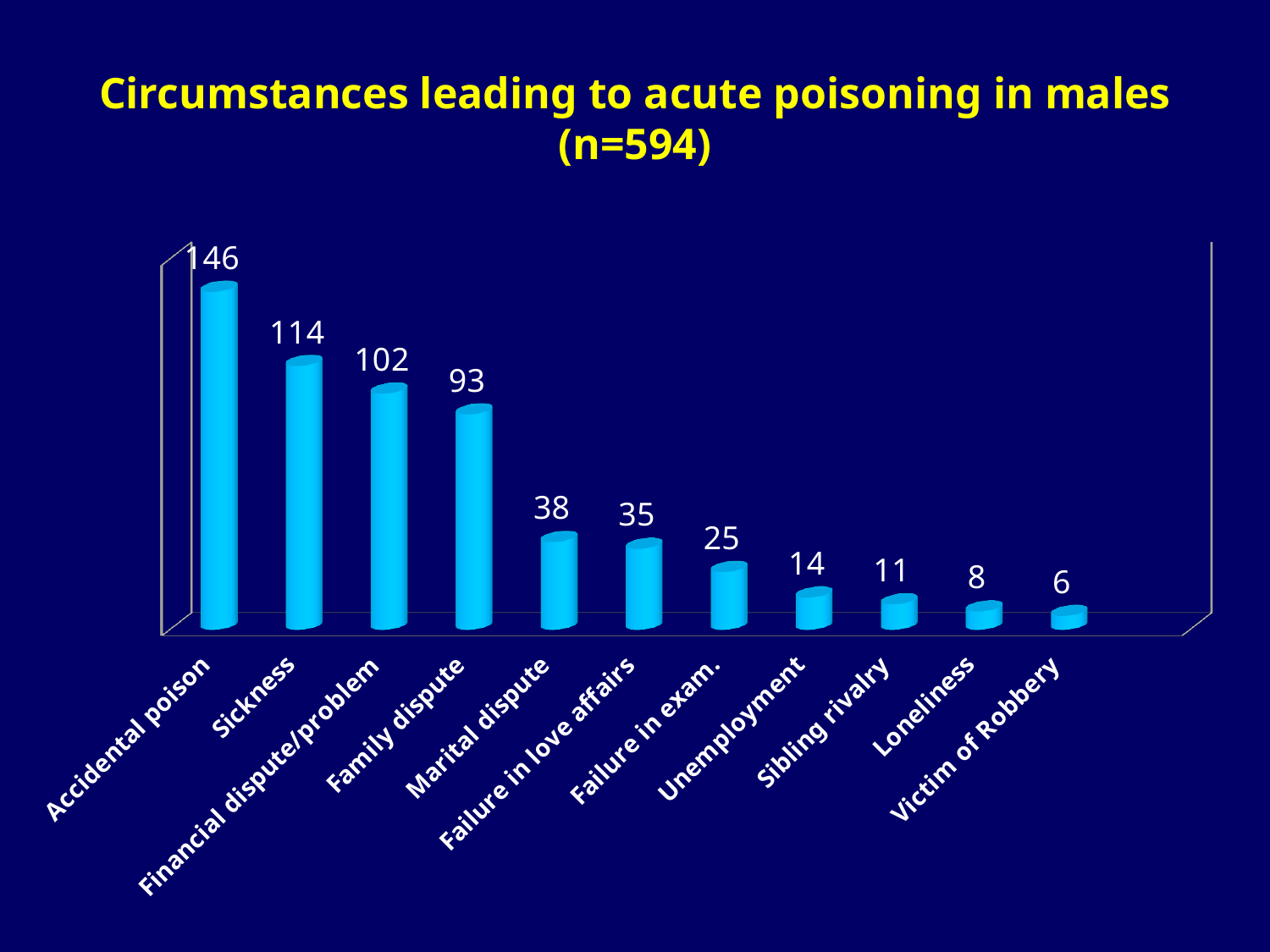
What is the value for Accidental poison? 146 Which circumstance has the lowest value? Victim of Robbery What is the value for Failure in love affairs? 35 What is the value for Loneliness? 8 Which is larger, the value for Unemployment or the value for Sibling rivalry? Unemployment What is the difference between the values for Marital dispute and Failure in exam.? 13 What kind of chart is shown on the slide? Bar chart What is the difference between the values for Sickness and Financial dispute/problem? 12 Which circumstance has the highest value? Accidental poison How many circumstances are shown on the chart? 11 What is the value for Family dispute? 93 Do the values rise or fall from left to right along the x axis? Fall